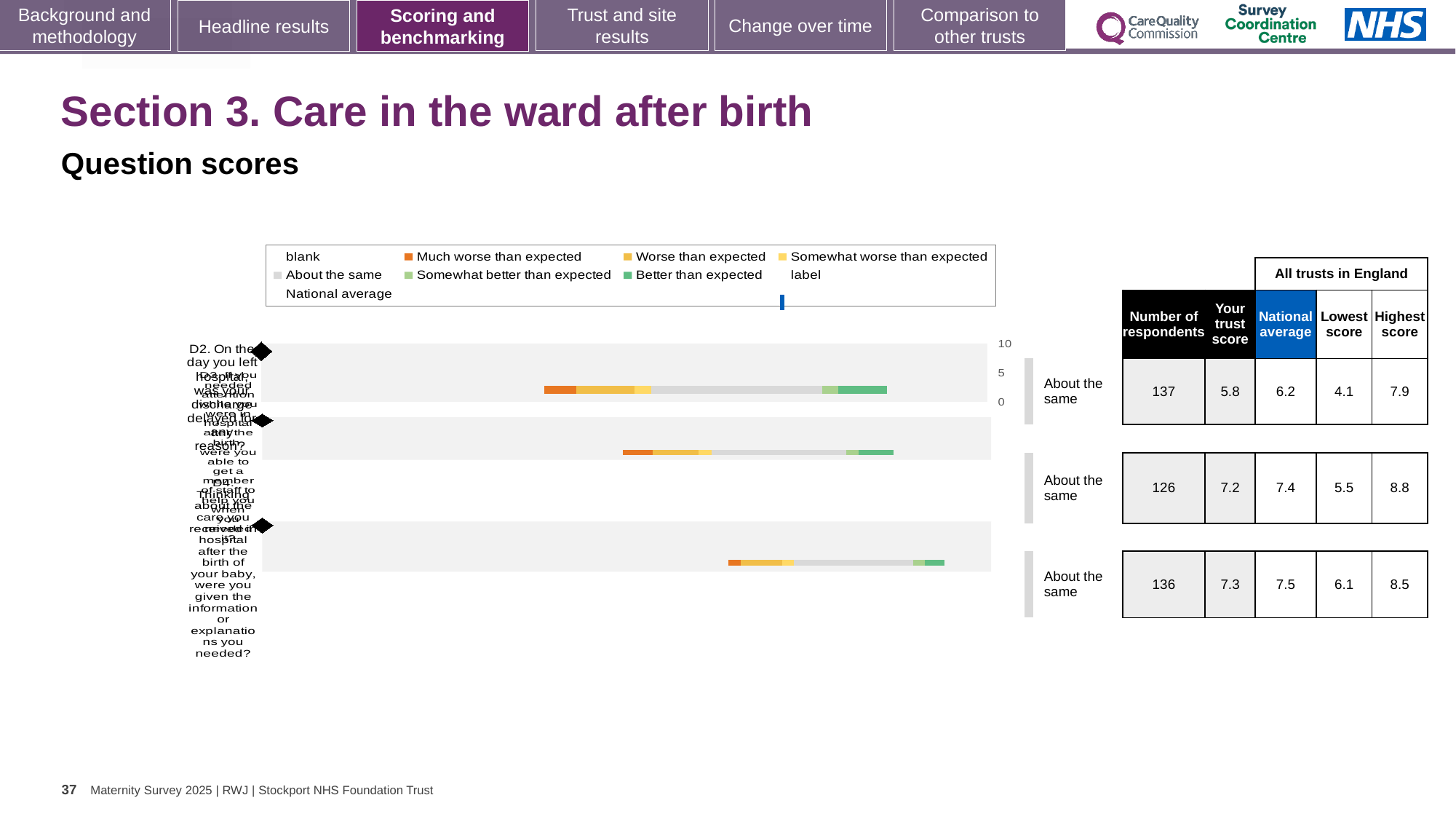
In the table beside the chart, what is the national average for the third (bottom) row? 7.5 How many bars (question rows) are plotted in the chart? 3 In the chart legend, what colour represents 'Much worse than expected'? orange In the table beside the chart, what is the difference between the national average and 'Your trust score' for the first row? 0.4 In the table beside the chart, for the third row, which is larger: 'Your trust score' or the national average? national average What is the subtitle shown above the chart? Question scores In the table beside the chart, which row has the lowest 'Lowest score' value? the first row (4.1) What kind of chart is shown on the slide? bar chart What benchmark category is shown next to each of the three bars in the chart? About the same In the table beside the chart, what is 'Your trust score' for the second row? 7.2 In the table beside the chart, which row has the highest 'Highest score' value? the second row (8.8) In the table beside the chart, what is the number of respondents for the first (top) row? 137